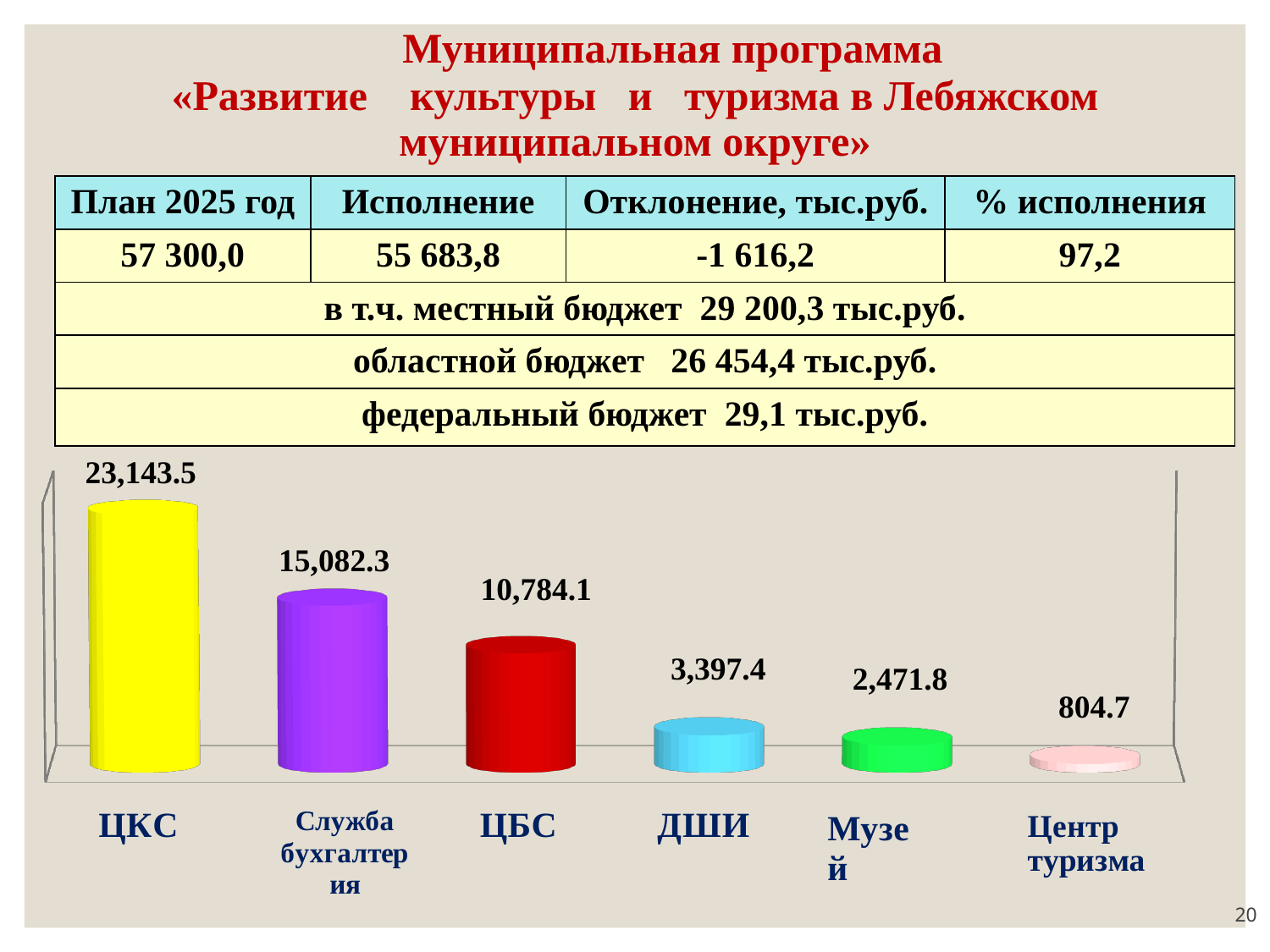
Which category has the lowest value in the bar chart? Центр туризма What is the difference between the values for ДШИ and Музей? 925.6 What is the value shown for Музей in the bar chart? 2,471.8 Do the values in the bar chart rise or fall from left to right? fall What is the value shown for ЦБС in the bar chart? 10,784.1 What is the value shown for Центр туризма in the bar chart? 804.7 Which has a larger value, ЦБС or ДШИ? ЦБС How many categories are shown in the bar chart? 6 What is the difference between the values for ЦКС and Служба бухгалтерия? 8,061.2 What is the value shown for Служба бухгалтерия in the bar chart? 15,082.3 What is the value shown for ЦКС in the bar chart? 23,143.5 Which category has the highest value in the bar chart? ЦКС